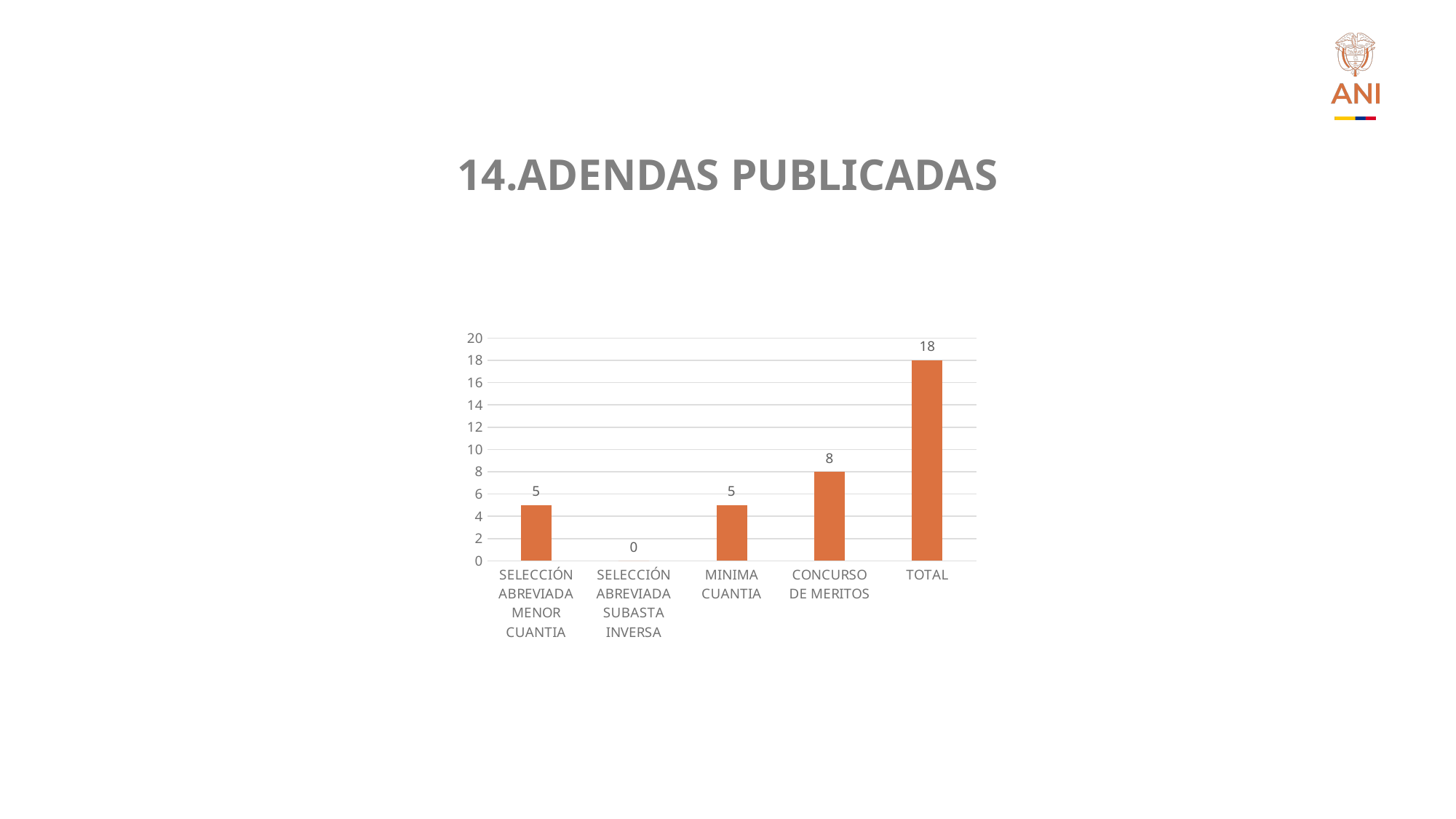
How many categories are shown on the x axis? 5 Which is larger, the value for CONCURSO DE MERITOS or the value for MINIMA CUANTIA? CONCURSO DE MERITOS Which category has the lowest value? SELECCIÓN ABREVIADA SUBASTA INVERSA What is the value for SELECCIÓN ABREVIADA MENOR CUANTIA? 5 What is the title of the slide above the chart? 14.ADENDAS PUBLICADAS What is the value for TOTAL? 18 What kind of chart is shown on the slide? bar chart What is the difference between the values for TOTAL and CONCURSO DE MERITOS? 10 What is the value for SELECCIÓN ABREVIADA SUBASTA INVERSA? 0 Is the value for TOTAL greater or less than 10? greater Which category has the highest value? TOTAL What is the value for CONCURSO DE MERITOS? 8